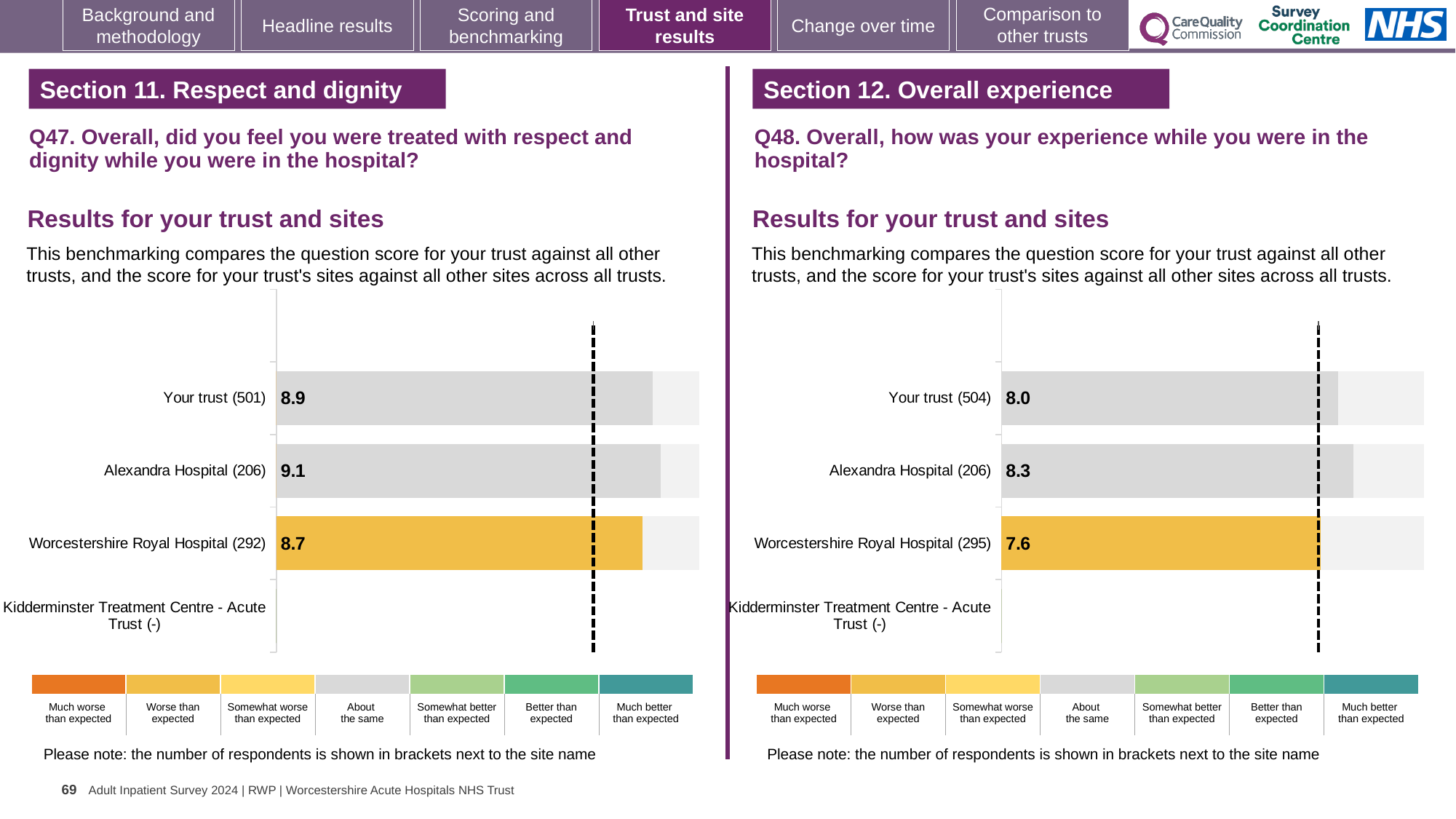
In the Q48 chart on the right, what is the score for Your trust (504)? 8.0 What type of chart is used for the Q48 results on the right? Bar chart In the Q48 chart on the right, which site has the lowest score among those with a value shown? Worcestershire Royal Hospital (295) How many categories (rows) are listed on the y axis of the Q47 chart on the left? 4 In the Q48 chart on the right, what is the score for Worcestershire Royal Hospital (295)? 7.6 In the Q48 chart on the right, what colour is the bar for Worcestershire Royal Hospital? Yellow/orange In the Q47 chart on the left, which site has the highest score? Alexandra Hospital (206) In the Q48 chart on the right, what is the difference between the scores for Alexandra Hospital and Worcestershire Royal Hospital? 0.7 In the Q47 chart on the left, what is the difference between the scores for Alexandra Hospital and Worcestershire Royal Hospital? 0.4 In the Q47 chart on the left, what is the score for Alexandra Hospital (206)? 9.1 In the Q47 chart on the left, what is the score for Your trust (501)? 8.9 In the Q48 chart on the right, which is larger: the score for Alexandra Hospital or the score for Your trust? Alexandra Hospital